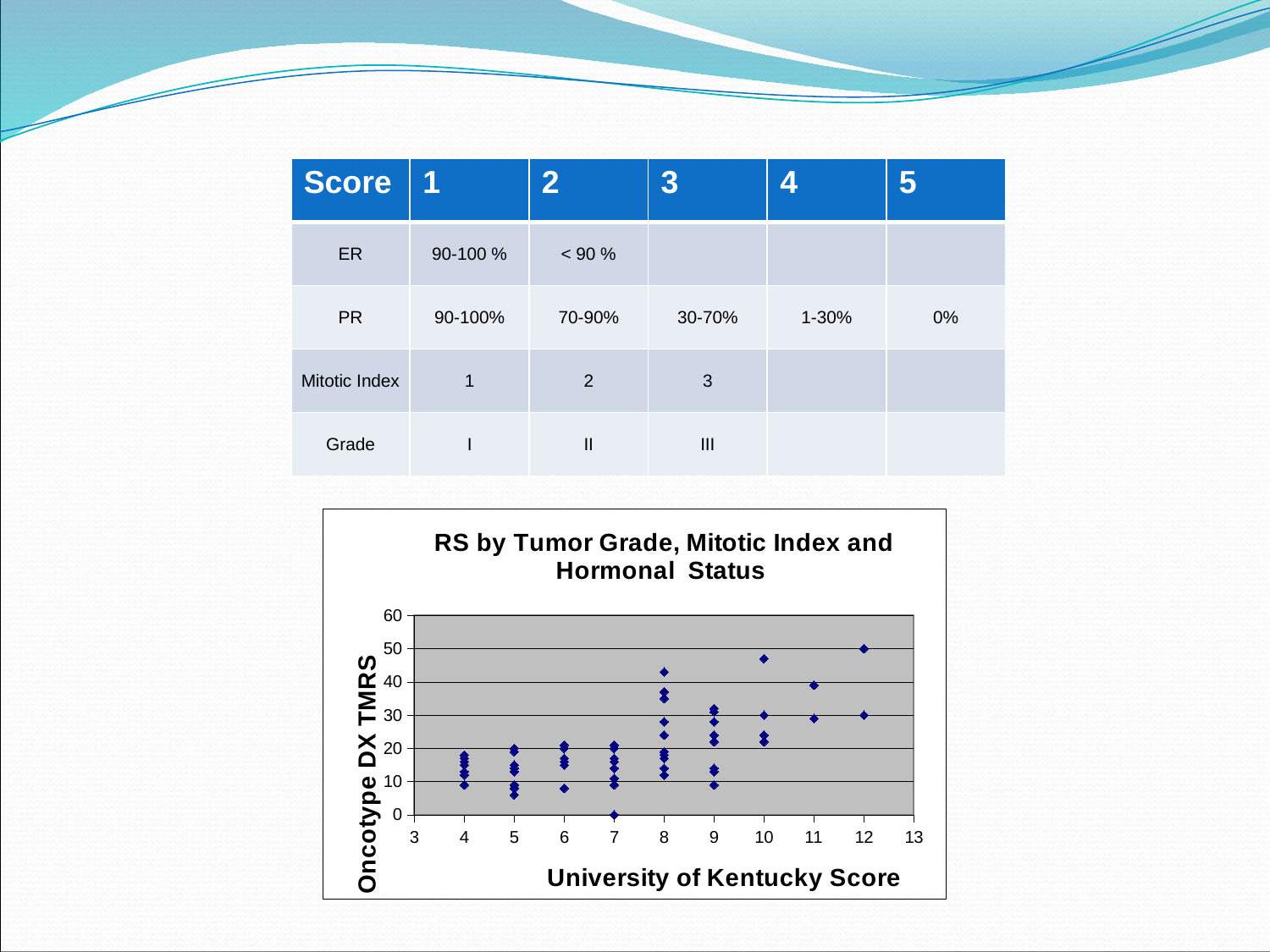
Is the lowest point at a University of Kentucky Score of 7 greater or less than 10? less What kind of chart is shown on the slide? scatter chart Is the highest point at a University of Kentucky Score of 8 greater or less than 30? greater How many points are plotted at a University of Kentucky Score of 12? 2 Is the highest point at a University of Kentucky Score of 12 greater or less than 40? greater What is the label of the x axis of the chart? University of Kentucky Score Do the Oncotype DX TMRS values generally rise or fall as the University of Kentucky Score increases? rise What is the title of the chart? RS by Tumor Grade, Mitotic Index and Hormonal Status How many points are plotted at a University of Kentucky Score of 11? 2